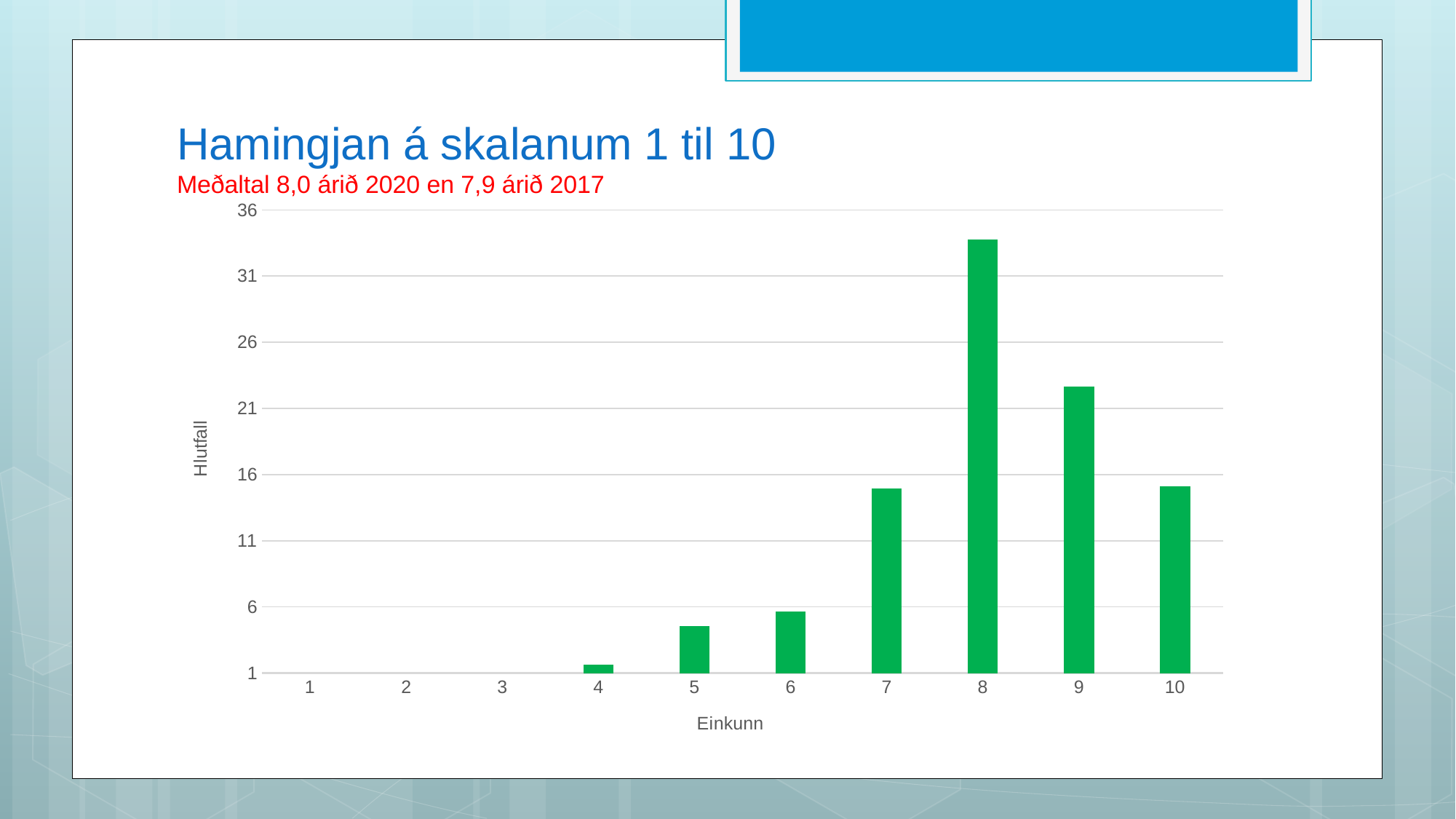
Is the value for Einkunn 10 greater or less than 11? greater Is the value for Einkunn 7 greater or less than 16? less Which Einkunn category has the tallest bar? 8 Which has the larger value, Einkunn 5 or Einkunn 6? 6 Do the values rise or fall from Einkunn 4 to Einkunn 8? rise Is the value for Einkunn 9 greater or less than 21? greater What is the label of the y axis? Hlutfall How many Einkunn categories are shown on the x axis? 10 What kind of chart is shown on the slide? bar chart Which has the larger value, Einkunn 9 or Einkunn 10? 9